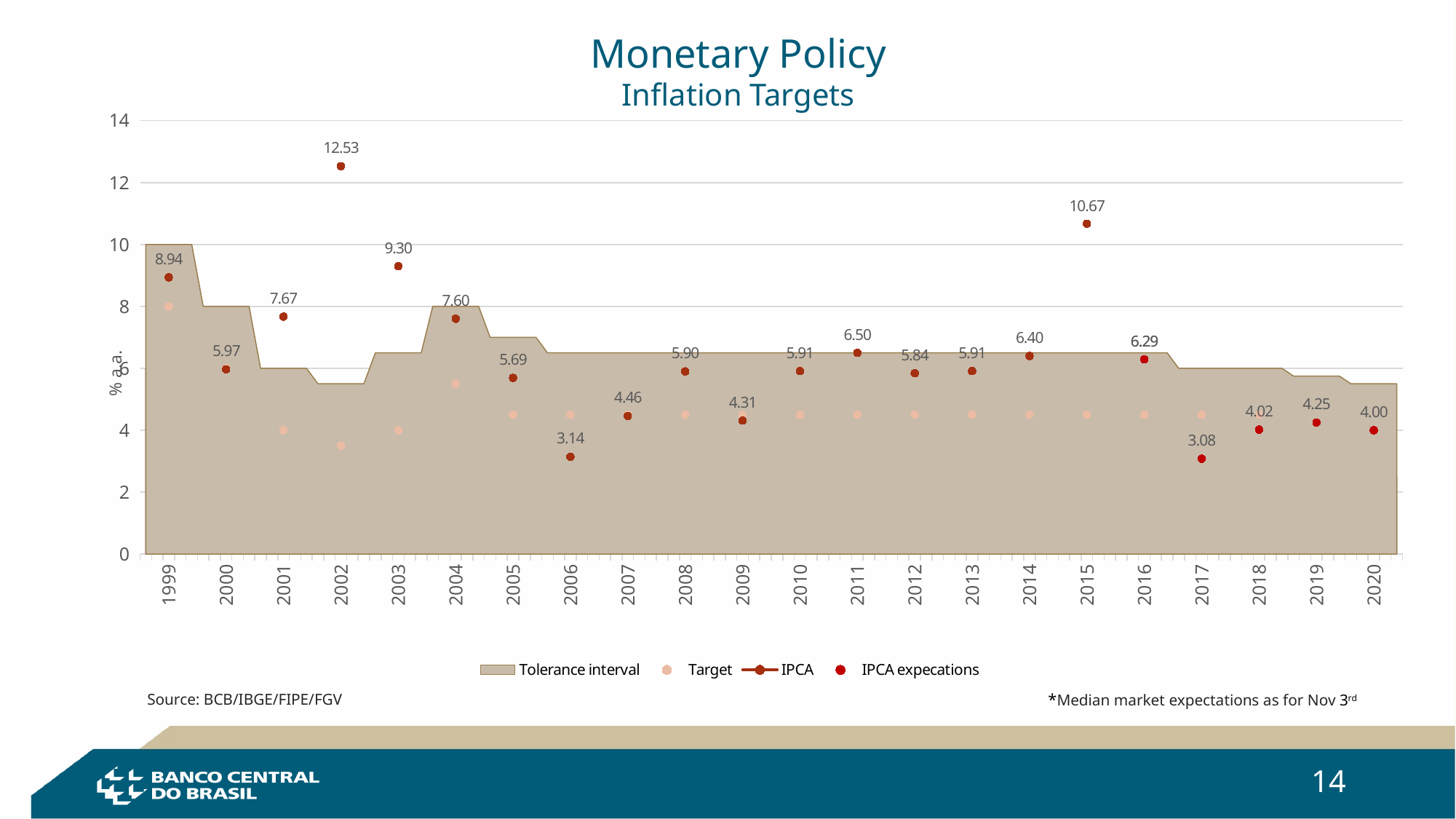
What is the IPCA value for 2015? 10.67 Do the labelled values rise or fall from 2013 to 2015? rise How many series does the legend list? 4 Which is larger, the IPCA value for 2011 or for 2014? 2011 What is the difference between the IPCA values for 2002 and 2003? 3.23 In which year is the labelled value lowest? 2017 What is the IPCA value for 2002? 12.53 Is the Target value for 2010 greater or less than 6? less How many years are shown on the x axis? 22 In which year is the labelled IPCA value highest? 2002 What is the IPCA value for 2006? 3.14 What is the IPCA expectation value for 2020? 4.00